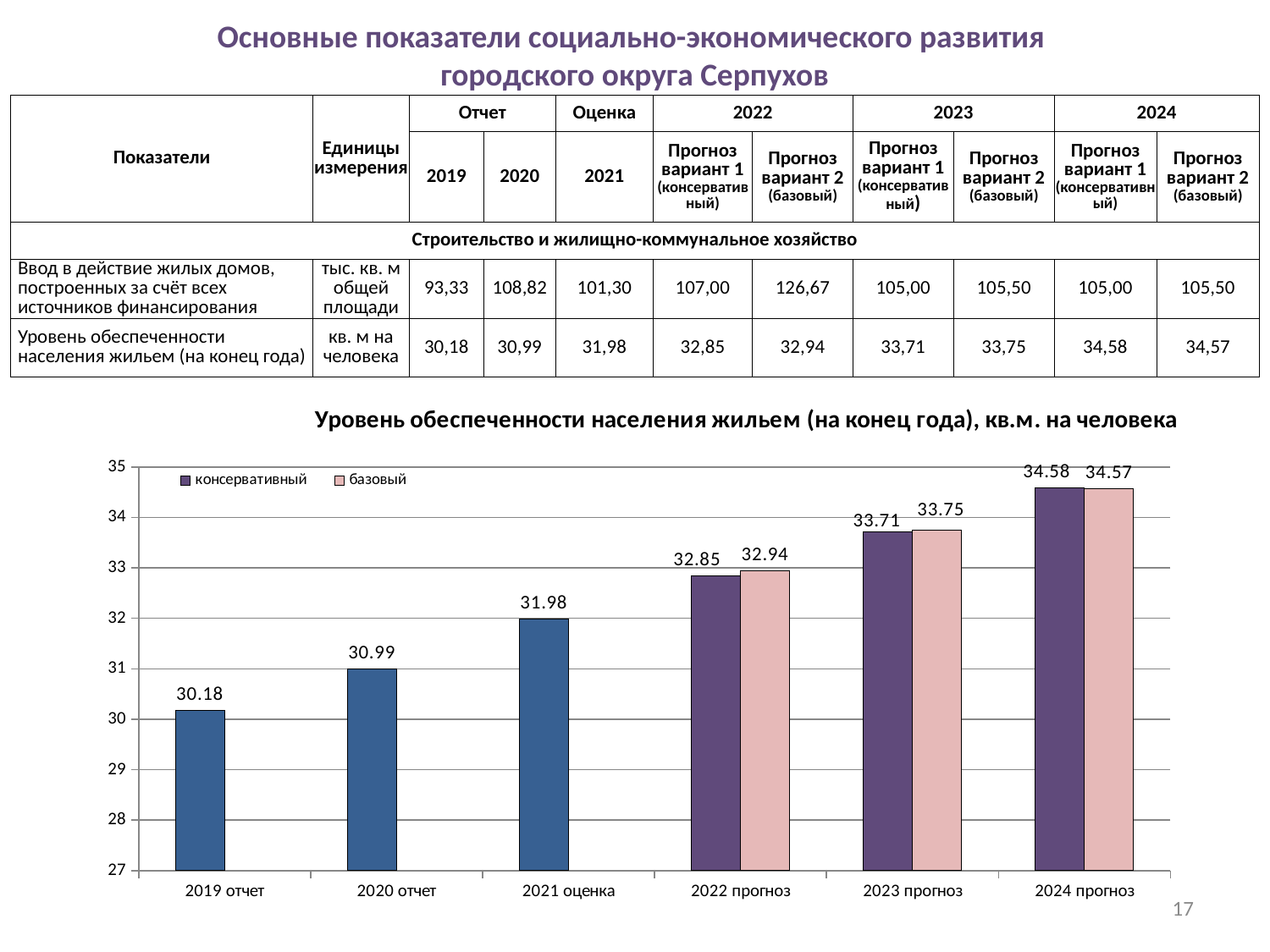
What is the базовый value for 2022 прогноз? 32.94 Is the value for 2021 оценка greater or less than 32? less Which category has the lowest value in the chart? 2019 отчет What is the консервативный value for 2023 прогноз? 33.71 What is the difference between the 2020 отчет value and the 2019 отчет value? 0.81 What is the value for 2019 отчет in the chart? 30.18 What is the value for 2021 оценка in the chart? 31.98 Which is larger for 2022 прогноз: the консервативный value or the базовый value? базовый What is the difference between the базовый and консервативный values for 2023 прогноз? 0.04 What type of chart is shown on the slide? bar chart How many series does the chart legend list? 2 How many categories are shown on the x axis of the chart? 6